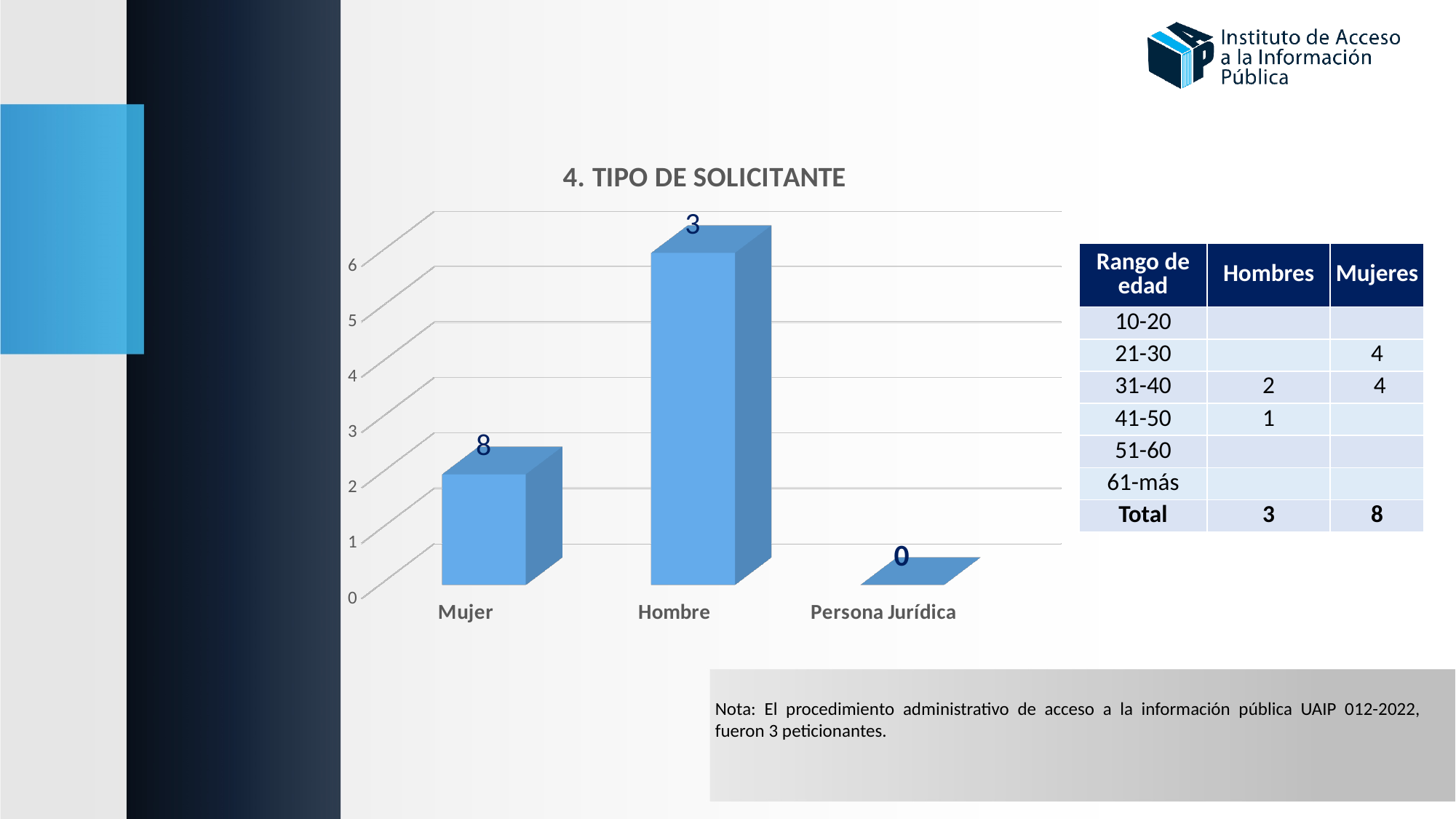
How many categories are shown on the x axis of the chart? 3 What value is printed for Persona Jurídica? 0 What value is printed above the Hombre bar? 3 What is the title of the chart? 4. TIPO DE SOLICITANTE What kind of chart is shown on the slide? Bar chart What value is printed above the Mujer bar? 8 What is the difference between the printed values for Mujer and Hombre? 5 What is the highest tick value shown on the vertical axis of the chart? 6 Which category has the lowest value in the chart? Persona Jurídica